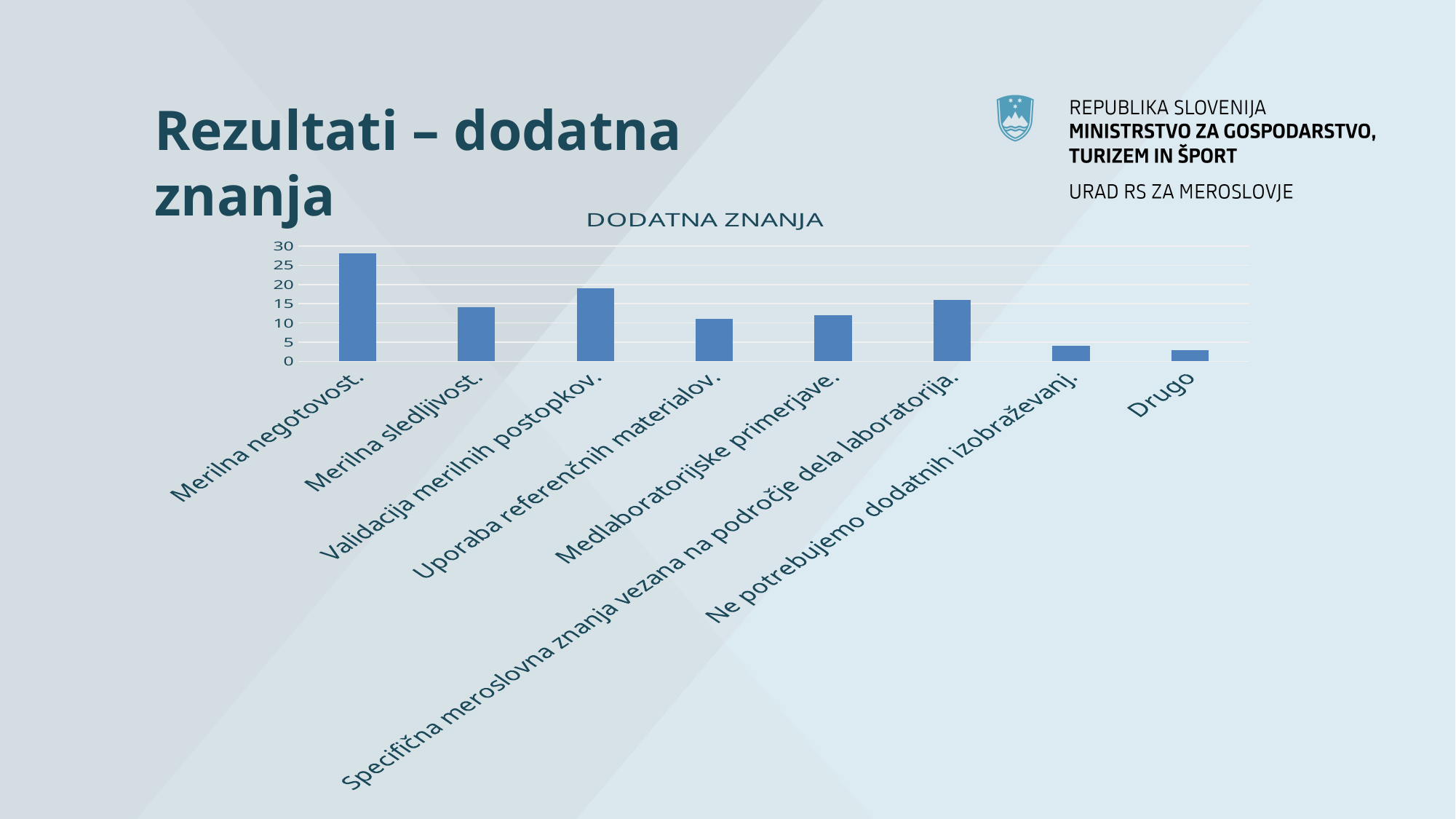
Which is larger, the value for Merilna sledljivost or the value for Medlaboratorijske primerjave? Merilna sledljivost. What kind of chart is shown on the slide? bar chart What is the title of the chart? DODATNA ZNANJA Is the value for Merilna negotovost greater or less than 25? greater Is the value for Specifična meroslovna znanja vezana na področje dela laboratorija greater or less than 10? greater Is the value for Uporaba referenčnih materialov greater or less than 15? less How many categories are shown on the x axis of the chart? 8 Which category has the highest bar in the chart? Merilna negotovost. Which category has the lowest bar in the chart? Drugo Which is larger, the value for Validacija merilnih postopkov or the value for Specifična meroslovna znanja vezana na področje dela laboratorija? Validacija merilnih postopkov.